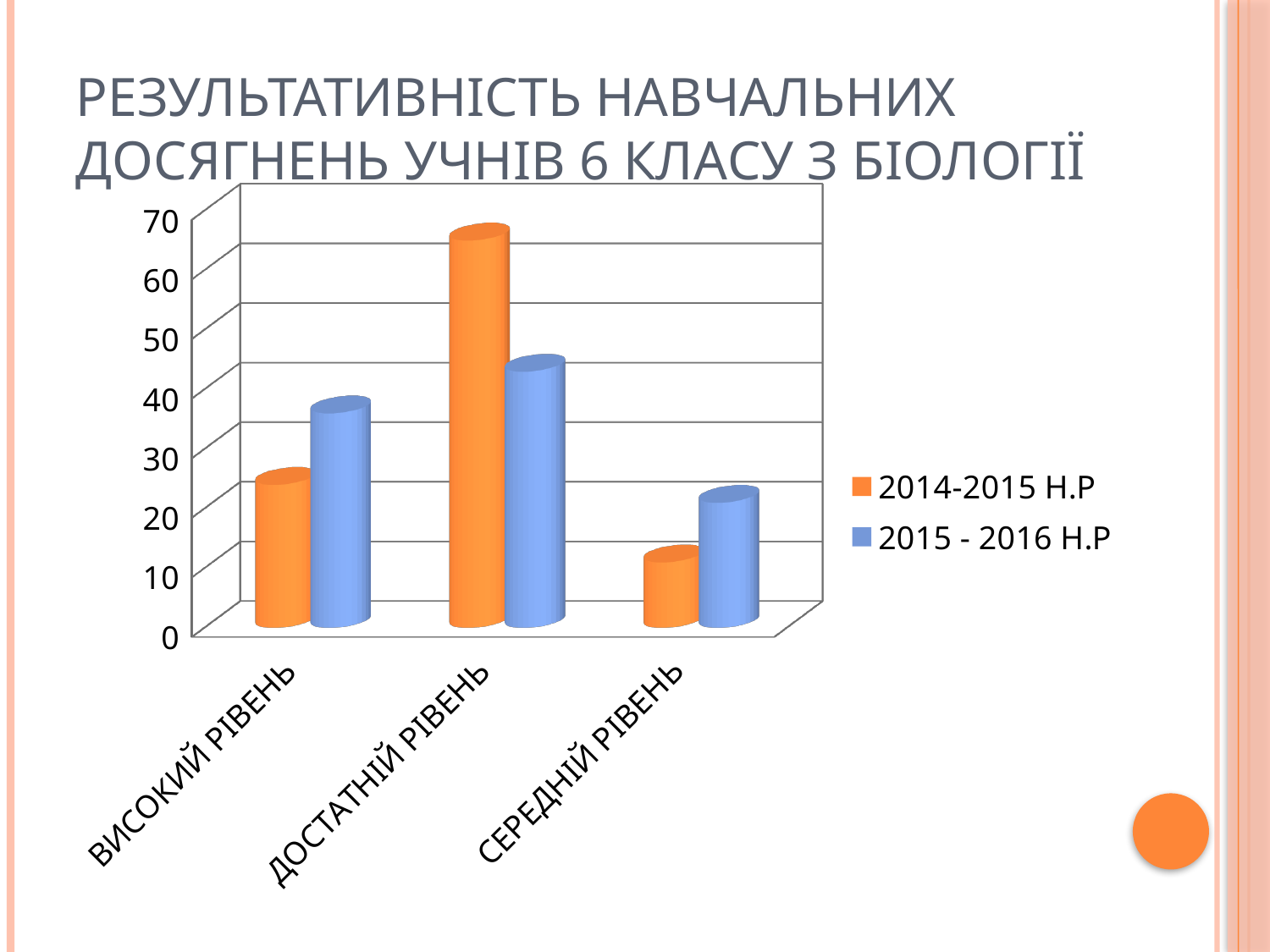
Is the value for СЕРЕДНІЙ РІВЕНЬ in the 2014-2015 Н.Р series greater or less than 20? less Is the value for ДОСТАТНІЙ РІВЕНЬ in the 2014-2015 Н.Р series greater or less than 60? greater Which colour represents the 2015 - 2016 Н.Р series in the legend? blue For ДОСТАТНІЙ РІВЕНЬ, which series has the larger value, 2014-2015 Н.Р or 2015 - 2016 Н.Р? 2014-2015 Н.Р Which category has the lowest value for the 2015 - 2016 Н.Р series? СЕРЕДНІЙ РІВЕНЬ What kind of chart is shown on the slide? bar chart How many series does the legend list? 2 Which category has the highest value for the 2015 - 2016 Н.Р series? ДОСТАТНІЙ РІВЕНЬ Which category has the highest value for the 2014-2015 Н.Р series? ДОСТАТНІЙ РІВЕНЬ Which category has the lowest value for the 2014-2015 Н.Р series? СЕРЕДНІЙ РІВЕНЬ For ВИСОКИЙ РІВЕНЬ, which series has the larger value, 2014-2015 Н.Р or 2015 - 2016 Н.Р? 2015 - 2016 Н.Р How many categories are shown on the x axis of the chart? 3